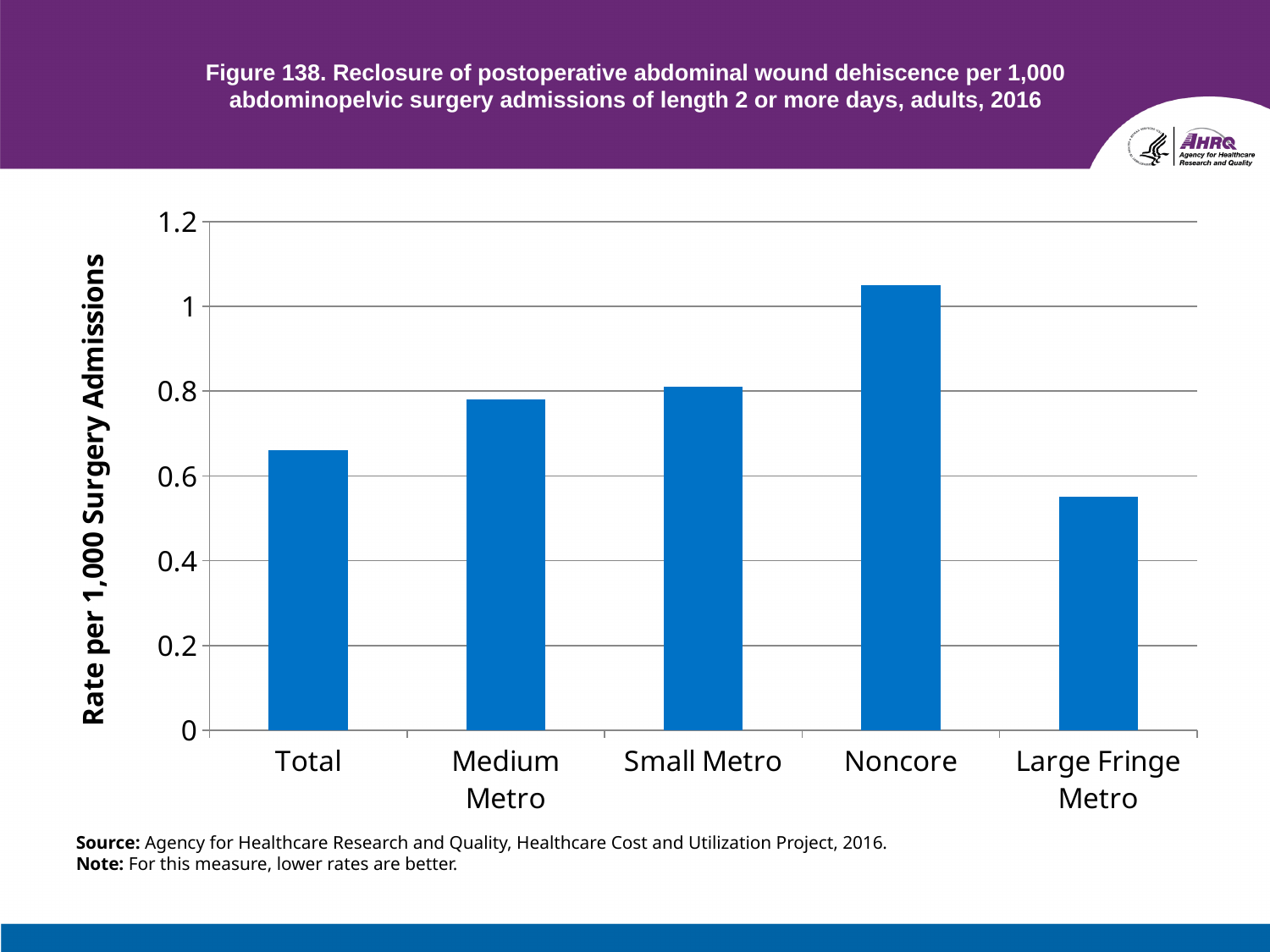
Which category has the lowest rate per 1,000 surgery admissions? Large Fringe Metro Is the value for Medium Metro greater or less than 0.6? greater Is the value for Small Metro greater or less than 1? less Is the value for Large Fringe Metro greater or less than 0.6? less What kind of chart is shown on the slide? bar chart Which is larger, the value for Noncore or the value for Large Fringe Metro? Noncore What is the title of the y axis of the chart? Rate per 1,000 Surgery Admissions Which is larger, the value for Total or the value for Medium Metro? Medium Metro How many categories are shown on the x axis of the chart? 5 Which category has the highest rate per 1,000 surgery admissions? Noncore